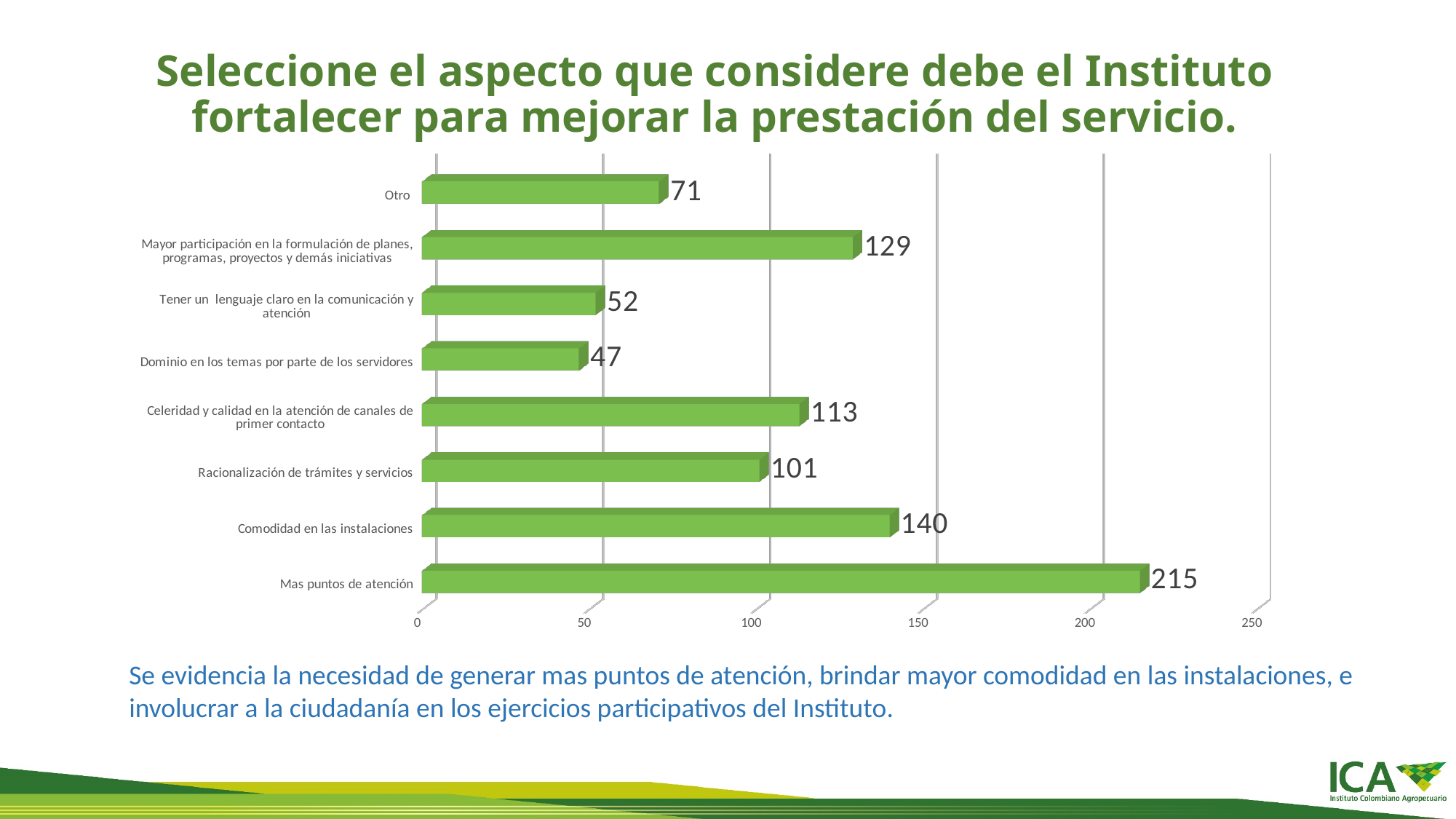
What is the value for "Otro"? 71 What is the difference between the values for "Celeridad y calidad en la atención de canales de primer contacto" and "Racionalización de trámites y servicios"? 12 What kind of chart is shown on the slide? Bar chart What is the maximum value shown on the horizontal axis? 250 How many categories are shown in the chart? 8 Which category has the highest value? Mas puntos de atención Which is larger: the value for "Mayor participación en la formulación de planes, programas, proyectos y demás iniciativas" or the value for "Celeridad y calidad en la atención de canales de primer contacto"? Mayor participación en la formulación de planes, programas, proyectos y demás iniciativas What is the difference between the values for "Mas puntos de atención" and "Comodidad en las instalaciones"? 75 What is the value for "Comodidad en las instalaciones"? 140 Which category has the lowest value? Dominio en los temas por parte de los servidores What is the value for "Mas puntos de atención"? 215 What is the value for "Dominio en los temas por parte de los servidores"? 47